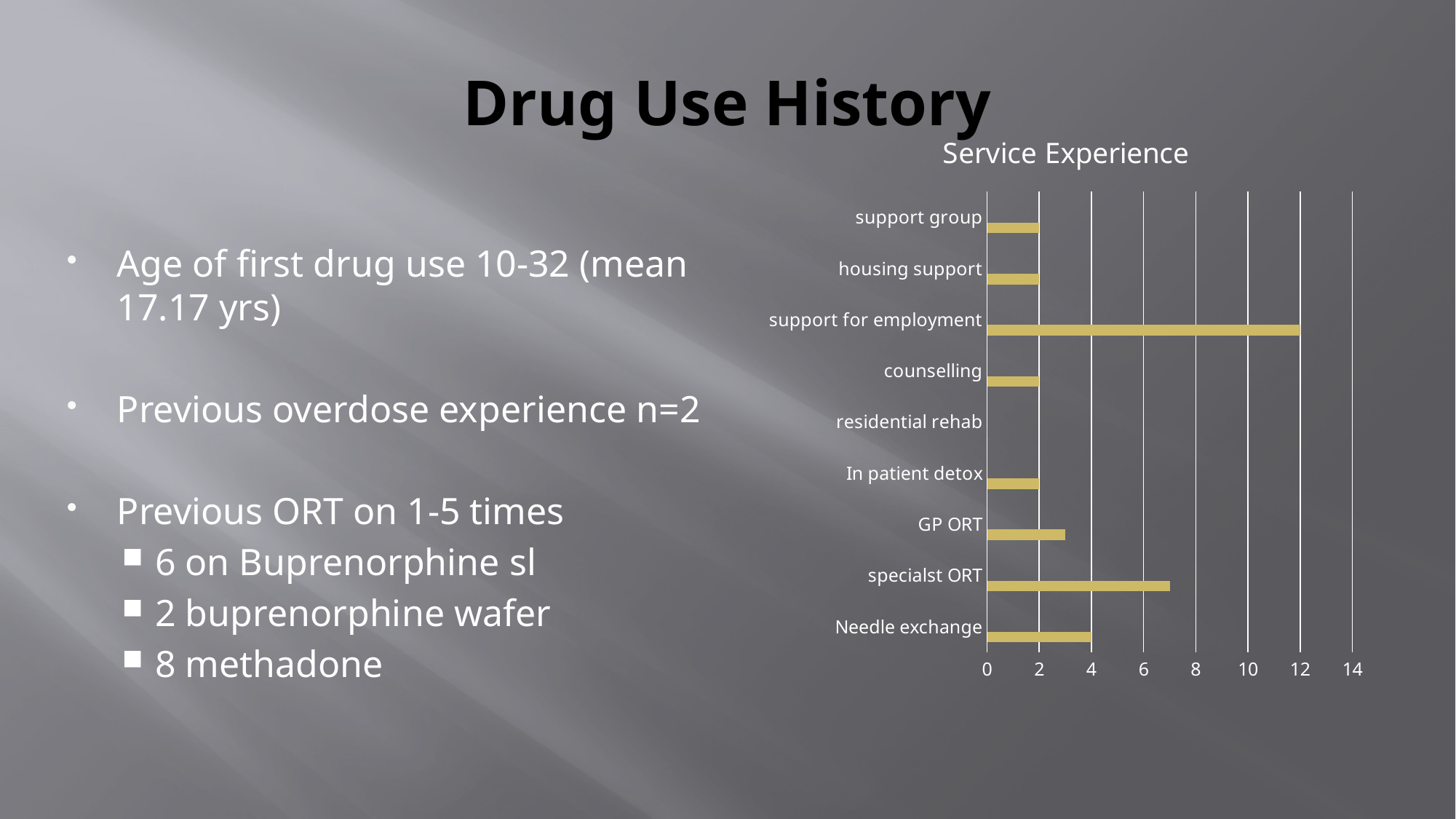
What is the difference between the values for 'support for employment' and 'Needle exchange'? 8 What is the title of the chart on the slide? Service Experience Which category has the lowest value on the Service Experience chart? residential rehab What is the value for 'Needle exchange' on the Service Experience chart? 4 How many categories are shown on the Service Experience chart? 9 Is the value for 'GP ORT' greater or less than 4? less What is the value for 'support group' on the Service Experience chart? 2 Is the value for 'specialst ORT' greater or less than 6? greater Which category has the highest value on the Service Experience chart? support for employment What type of chart is shown under the title 'Service Experience'? bar chart Which is larger on the Service Experience chart: 'Needle exchange' or 'housing support'? Needle exchange What is the value for 'support for employment' on the Service Experience chart? 12